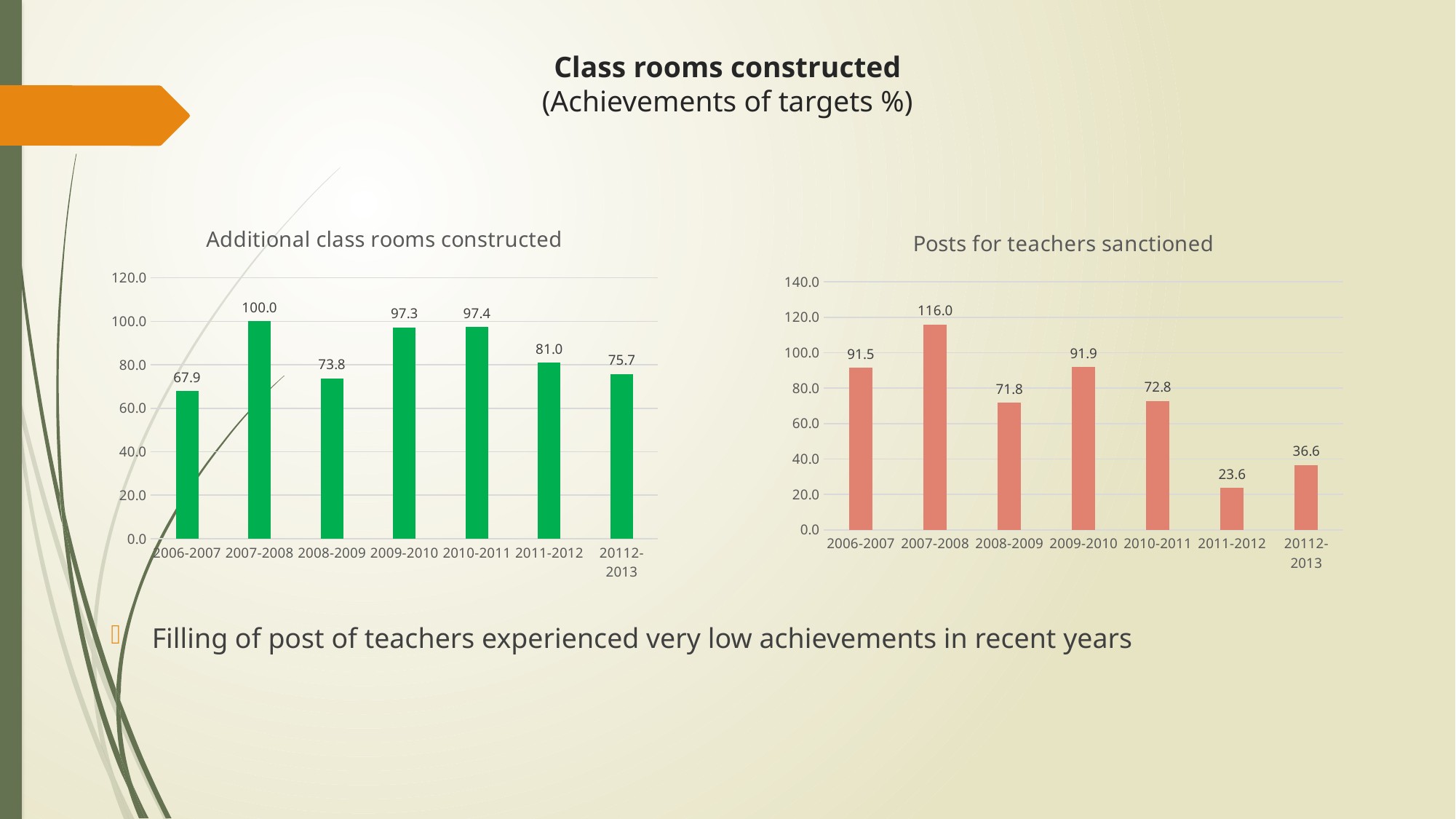
In the 'Additional class rooms constructed' chart, what is the value for 2007-2008? 100.0 In the 'Posts for teachers sanctioned' chart, which year has the highest value? 2007-2008 What colour are the bars in the 'Posts for teachers sanctioned' chart? Salmon/red In the 'Posts for teachers sanctioned' chart, is the value for 2009-2010 greater or less than 80.0? greater In the 'Additional class rooms constructed' chart, which is larger: the value for 2008-2009 or the value for 2011-2012? 2011-2012 What kind of chart is the 'Additional class rooms constructed' chart? Bar chart In the 'Posts for teachers sanctioned' chart, do the values rise or fall from 2010-2011 to 2011-2012? Fall In the 'Additional class rooms constructed' chart, what is the difference between the values for 2011-2012 and 20112-2013? 5.3 In the 'Additional class rooms constructed' chart, which year has the lowest value? 2006-2007 In the 'Posts for teachers sanctioned' chart, what is the difference between the values for 2007-2008 and 2011-2012? 92.4 How many year categories are shown in the 'Posts for teachers sanctioned' chart? 7 In the 'Posts for teachers sanctioned' chart, what is the value for 2011-2012? 23.6